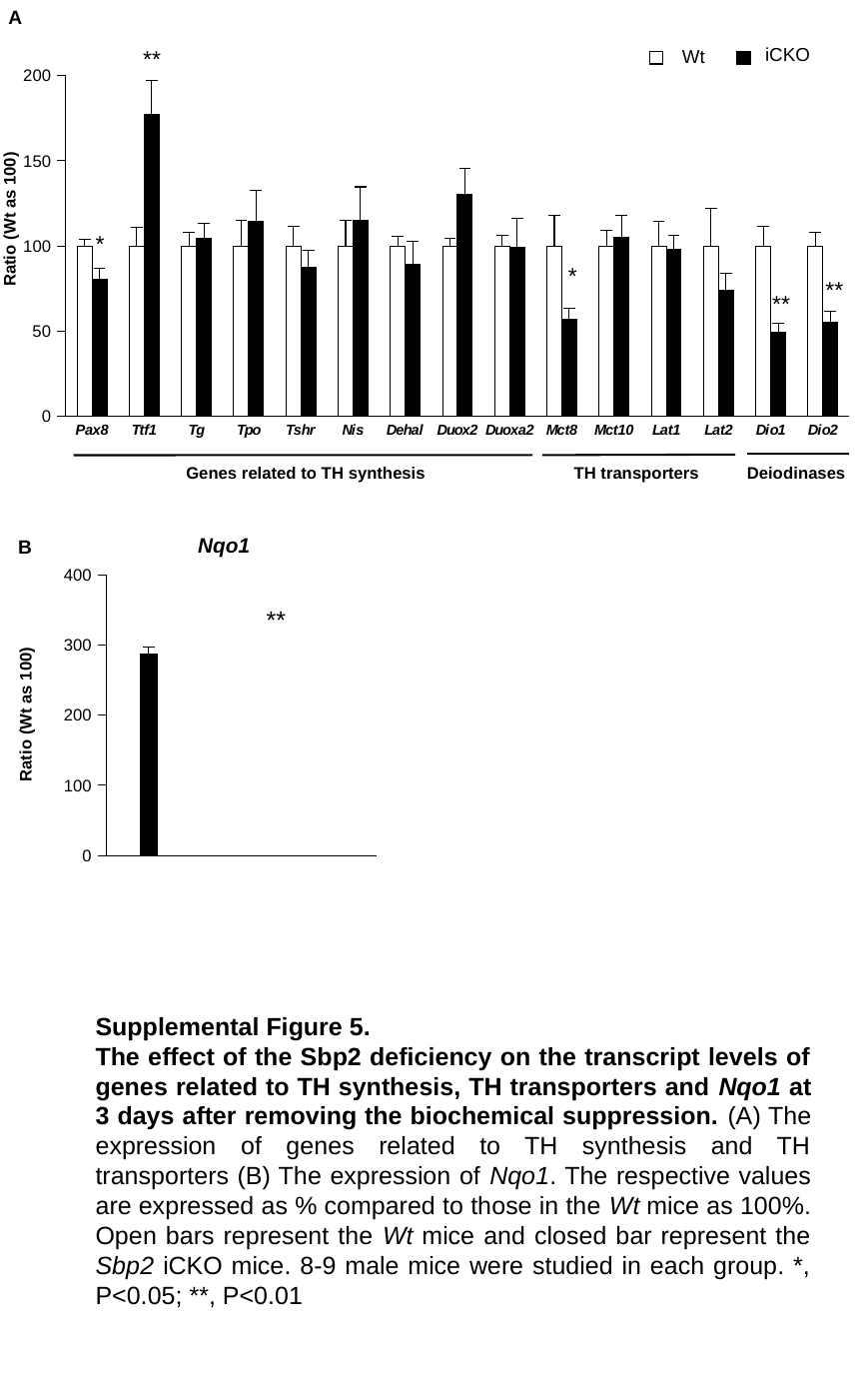
In chart A, which gene has the highest iCKO value? Ttf1 What is the y-axis label of chart B? Ratio (Wt as 100) In chart A, is the iCKO value for Lat2 greater or less than 100? less In chart A, is the iCKO value for Duox2 greater or less than 100? greater In chart A, which is larger: the iCKO value for Duox2 or the iCKO value for Mct8? Duox2 What kind of chart is chart A? bar chart In chart A, what are the two series named in the legend? Wt and iCKO In chart A, is the iCKO value for Ttf1 greater or less than 150? greater In chart A, how many genes are shown on the x axis? 15 In chart A, how many series does the legend list? 2